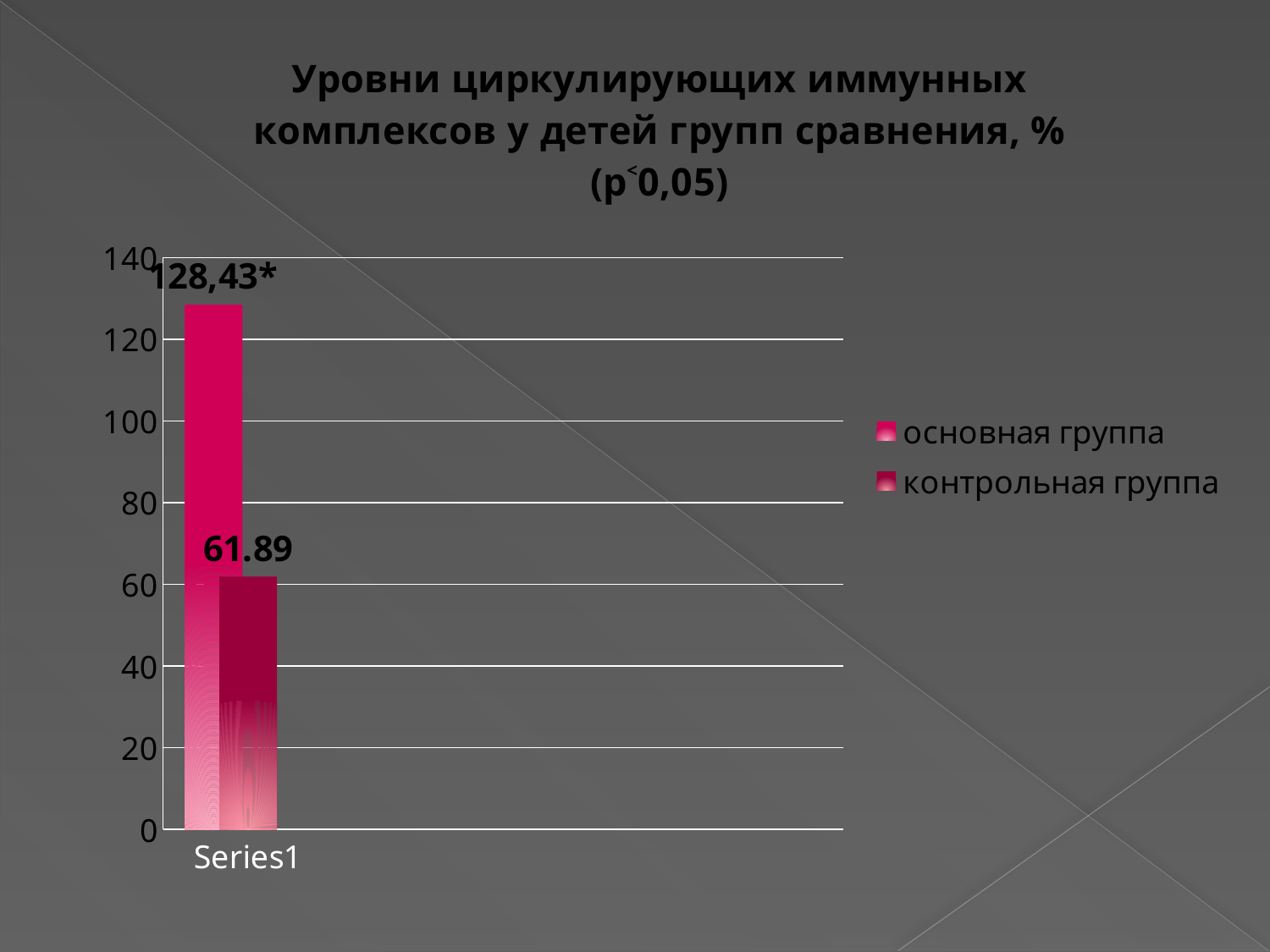
Which series has the higher value, основная группа or контрольная группа? основная группа Which series has the lowest value? контрольная группа How many categories are shown on the x axis? 1 Is the value for контрольная группа greater or less than 80? less How many series does the legend list? 2 What is the value for контрольная группа? 61.89 What is the value for основная группа? 128,43* What is the difference between the values for основная группа and контрольная группа? 66.54 Is the value for основная группа greater or less than 120? greater Which series has the highest value? основная группа What type of chart is shown on the slide? bar chart What is the label of the category on the x axis? Series1